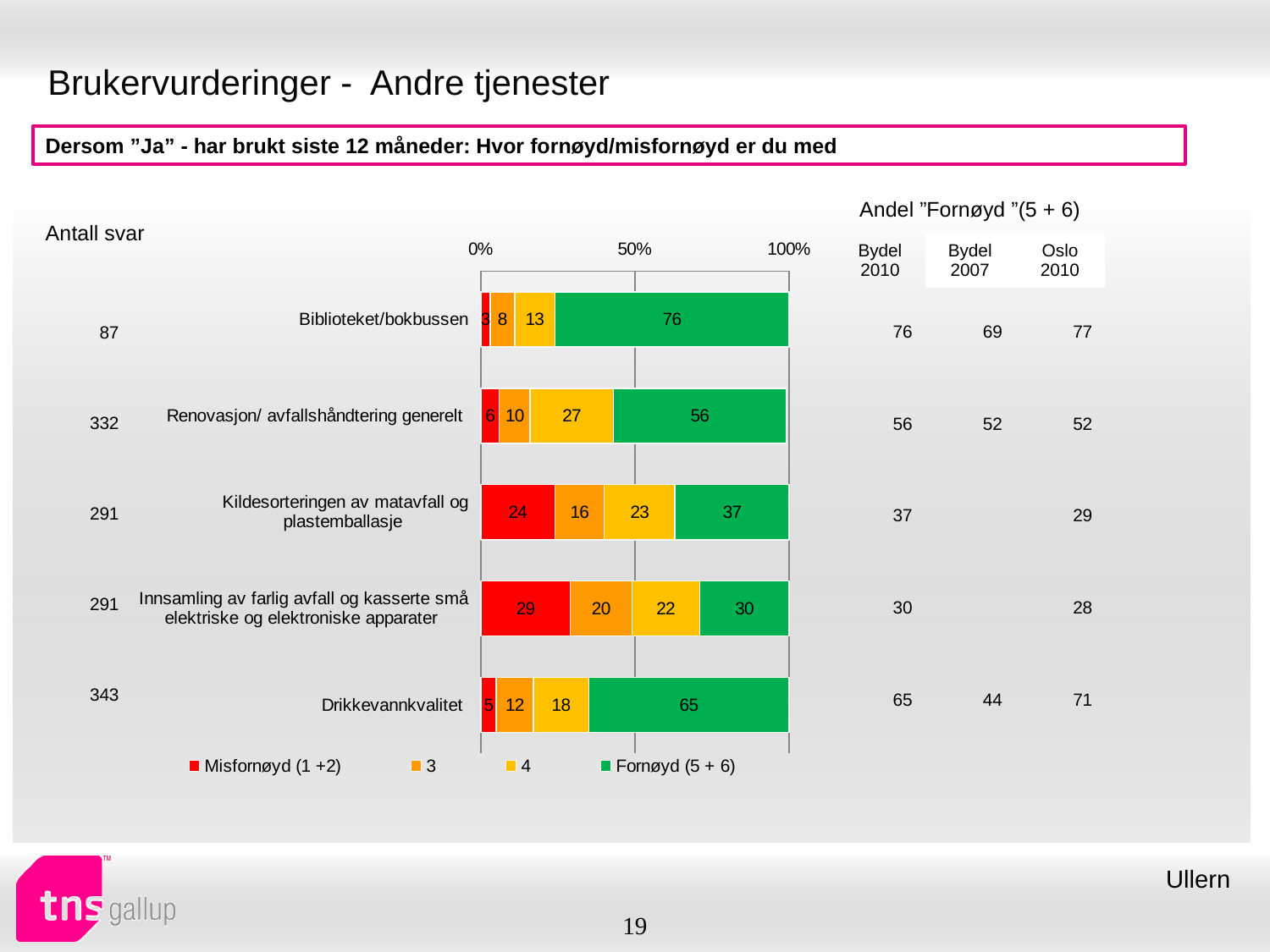
Which category has the lowest Fornøyd (5 + 6) value? Innsamling av farlig avfall og kasserte små elektriske og elektroniske apparater Which has the larger Misfornøyd (1 +2) value: Kildesorteringen av matavfall og plastemballasje or Innsamling av farlig avfall og kasserte små elektriske og elektroniske apparater? Innsamling av farlig avfall og kasserte små elektriske og elektroniske apparater What is the value of the Fornøyd (5 + 6) segment for Biblioteket/bokbussen? 76 What is the total of the stacked bar for Renovasjon/ avfallshåndtering generelt? 99 What is the value of the Misfornøyd (1 +2) segment for Innsamling av farlig avfall og kasserte små elektriske og elektroniske apparater? 29 What is the difference between the Fornøyd (5 + 6) values for Biblioteket/bokbussen and Drikkevannkvalitet? 11 How many series does the legend list? 4 Which category has the highest Fornøyd (5 + 6) value? Biblioteket/bokbussen What kind of chart is shown on the slide? Stacked bar chart What colour represents the Fornøyd (5 + 6) series in the chart? Green How many categories are shown in the chart? 5 What is the value of the '4' segment for Renovasjon/ avfallshåndtering generelt? 27